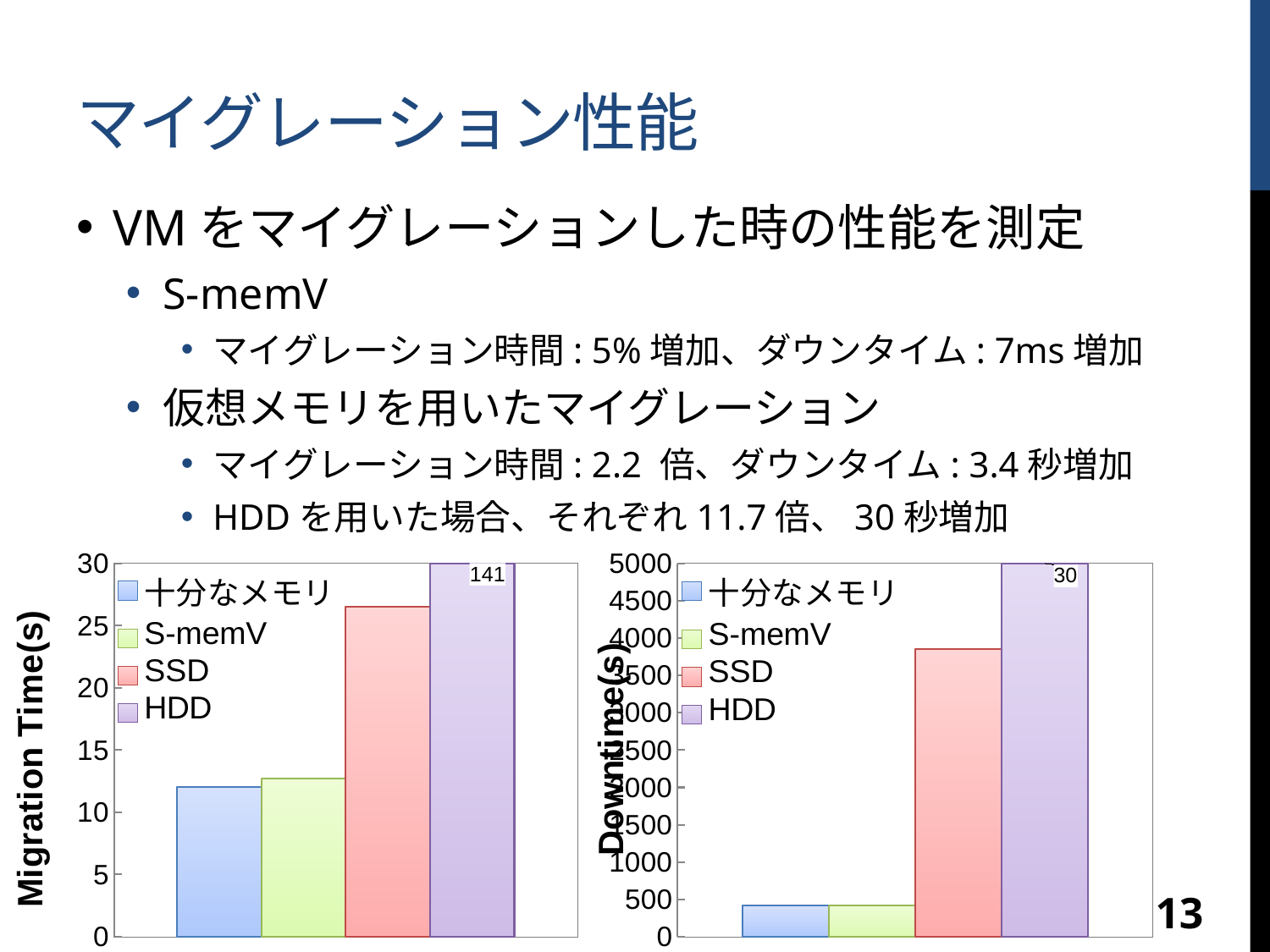
What is the y-axis title of the right chart? Downtime(s) How many series does the legend of the left chart (Migration Time) list? 4 In the right chart (Downtime), which series has the highest value? HDD In the right chart (Downtime), what value is printed as the data label on the HDD bar? 30 In the left chart (Migration Time), which series has the highest value? HDD In the left chart (Migration Time), is the value for 十分なメモリ greater or less than 15? less What kind of chart is the left chart (Migration Time)? bar chart In the left chart (Migration Time), what value is printed as the data label on the HDD bar? 141 In the right chart (Downtime), is the value for SSD greater or less than 3500? greater In the left chart (Migration Time), is the value for SSD greater or less than 25? greater In the left chart (Migration Time), which is larger, the value for SSD or the value for S-memV? SSD